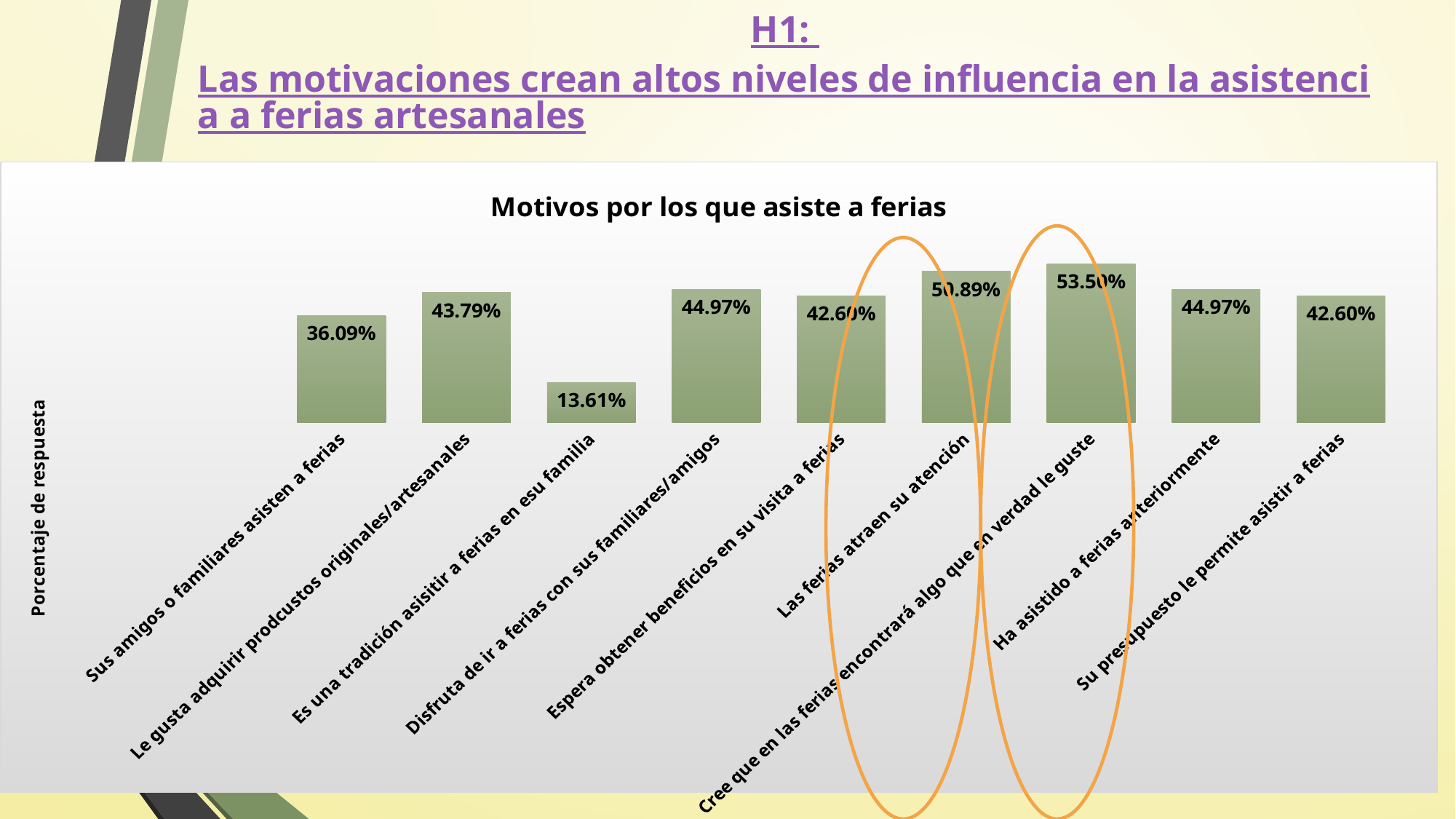
Which category has the highest value? Cree que en las ferias encontrará algo que en verdad le guste How many categories (bars) does the chart show? 9 What is the value for "Sus amigos o familiares asisten a ferias"? 36.09% What is the value for "Ha asistido a ferias anteriormente"? 44.97% Which category has the lowest value? Es una tradición asistir a ferias en esu familia What is the label of the vertical axis? Porcentaje de respuesta Which is larger: the value for "Le gusta adquirir prodcustos originales/artesanales" or the value for "Espera obtener beneficios en su visita a ferias"? Le gusta adquirir prodcustos originales/artesanales What is the value for "Las ferias atraen su atención"? 50.89% What is the difference between the values for "Cree que en las ferias encontrará algo que en verdad le guste" and "Las ferias atraen su atención"? 2.61% What is the value for "Es una tradición asistir a ferias en esu familia"? 13.61% What is the title of the chart? Motivos por los que asiste a ferias What type of chart is shown on the slide? bar chart